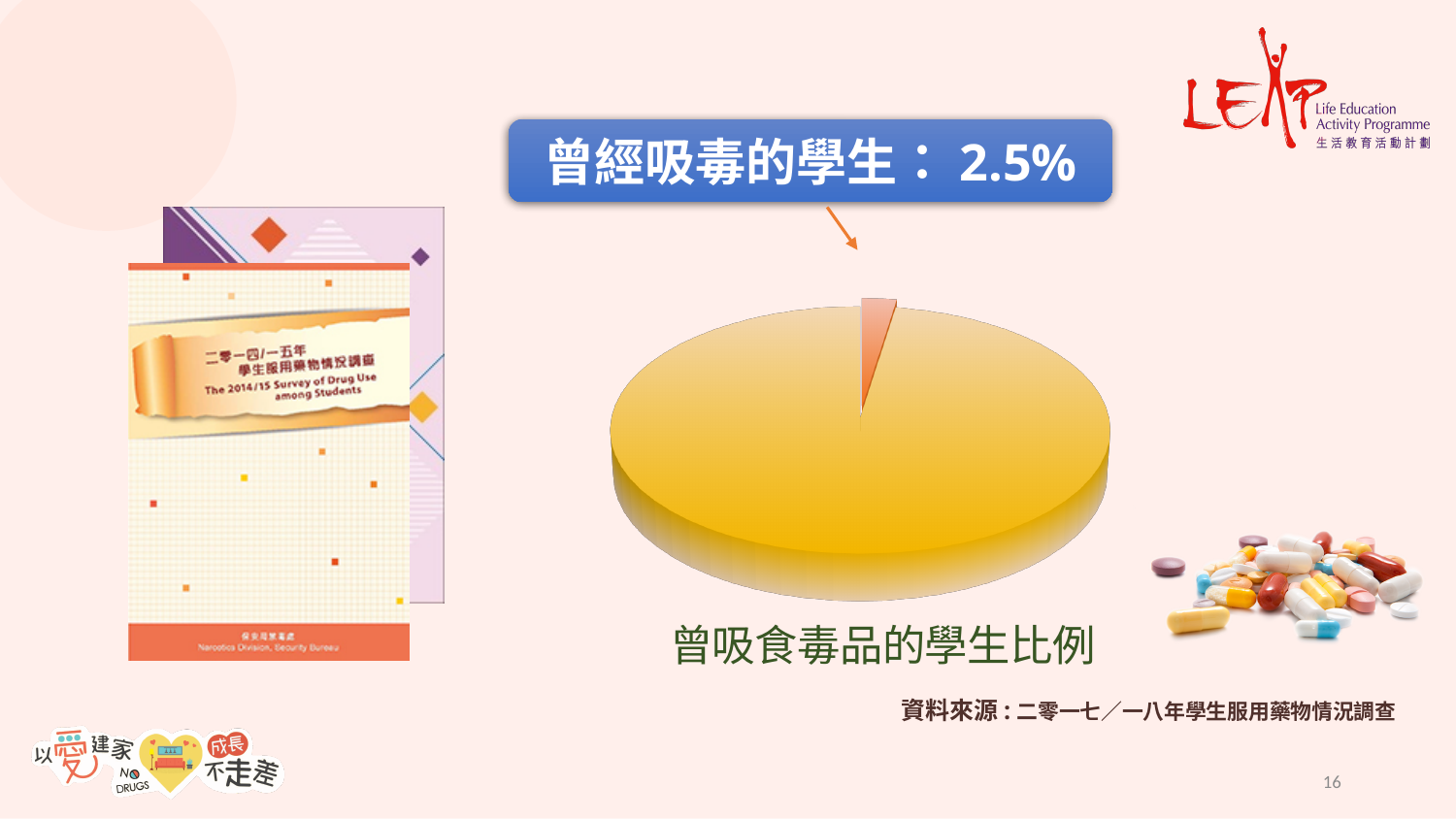
What percentage of students does the small orange slice of the pie chart represent (曾經吸毒的學生)? 2.5% What kind of chart is shown on the slide? pie chart How many slices does the pie chart have? 2 Which slice of the pie chart is larger, the orange slice or the yellow slice? the yellow slice Which slice of the pie chart is the smallest? the orange slice (曾經吸毒的學生, 2.5%) What colour is the slice representing students who have ever used drugs (曾經吸毒的學生)? orange What is the title shown below the pie chart? 曾吸食毒品的學生比例 According to the callout above the pie chart, what share of students have ever used drugs? 2.5%